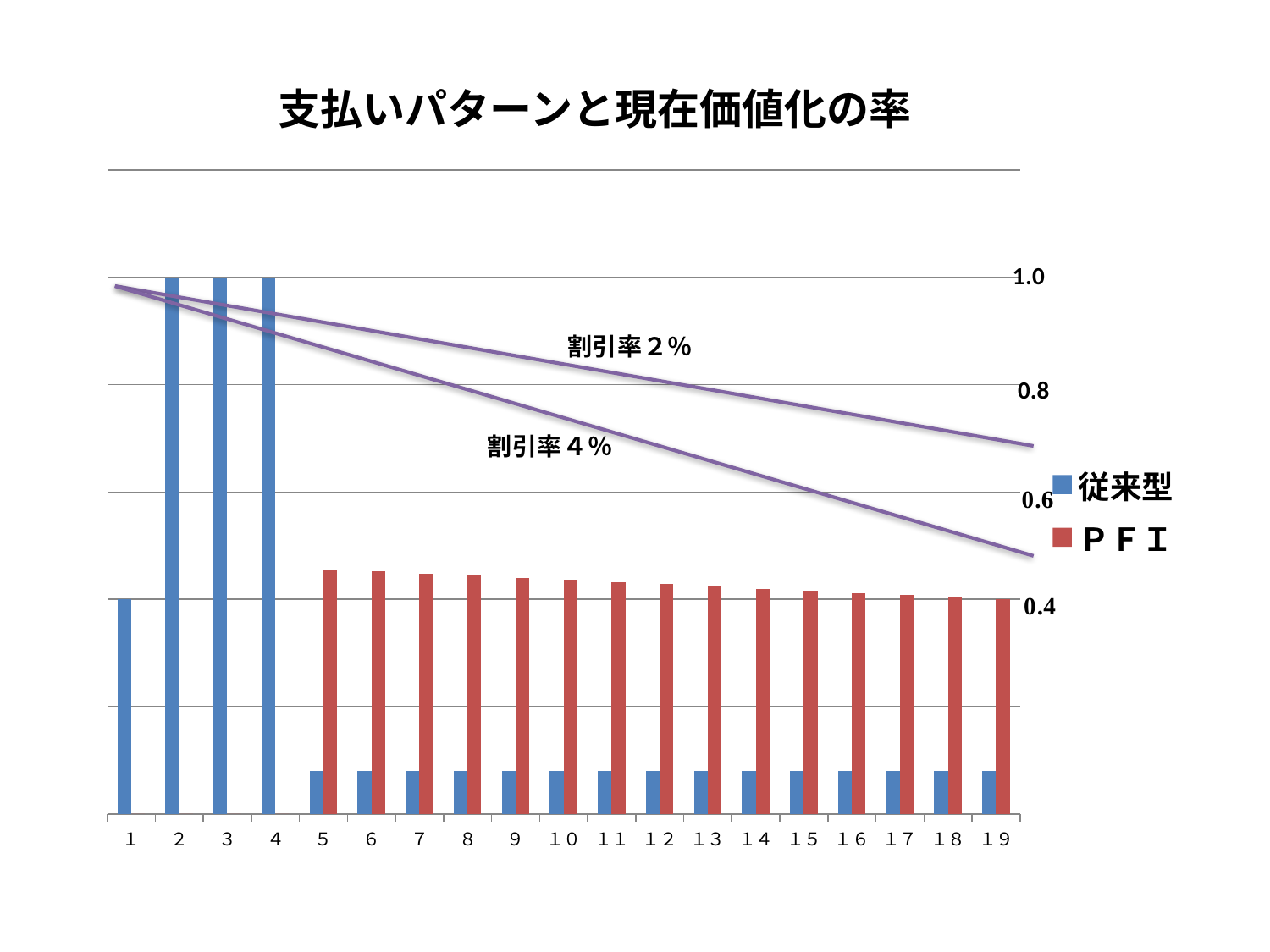
What is the value of 従来型 at category 1? 0.4 How many categories are shown on the x axis? 19 What is the title of the chart? 支払いパターンと現在価値化の率 Is the value of 従来型 at category 10 greater or less than 0.2? less Which category has the highest ＰＦＩ value? 5 Is the value of ＰＦＩ at category 5 greater or less than 0.6? less What are the labels of the two purple lines on the chart? 割引率２％ and 割引率４％ What kind of chart is shown on the slide? bar chart At category 8, which series has the larger value, 従来型 or ＰＦＩ? ＰＦＩ What is the value of 従来型 at category 3? 1.0 How many series does the legend list? 2 Do the ＰＦＩ values rise or fall from category 5 to category 19? fall